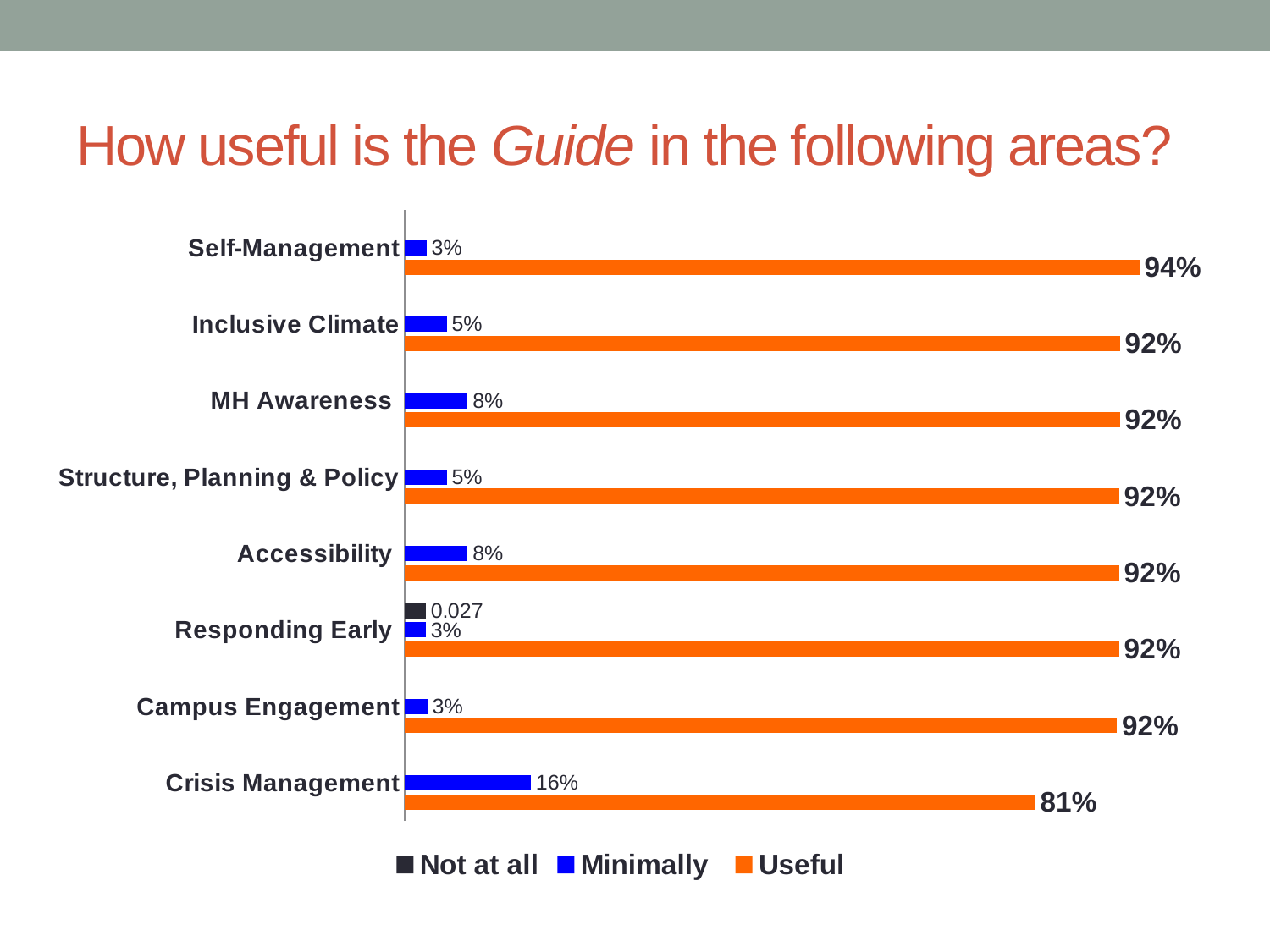
How many categories are shown on the chart? 8 Which is larger, the 'Minimally' value for MH Awareness or for Inclusive Climate? MH Awareness What is the 'Useful' value for Crisis Management? 81% What is the difference between the 'Useful' values for Self-Management and Crisis Management? 13% What kind of chart is shown on the slide? Bar chart Which category has the highest 'Useful' value? Self-Management What is the 'Useful' value for Self-Management? 94% What is the 'Minimally' value for Crisis Management? 16% How many series does the legend list? 3 Which category has the lowest 'Useful' value? Crisis Management Which category has the highest 'Minimally' value? Crisis Management What is the 'Not at all' value for Responding Early? 0.027